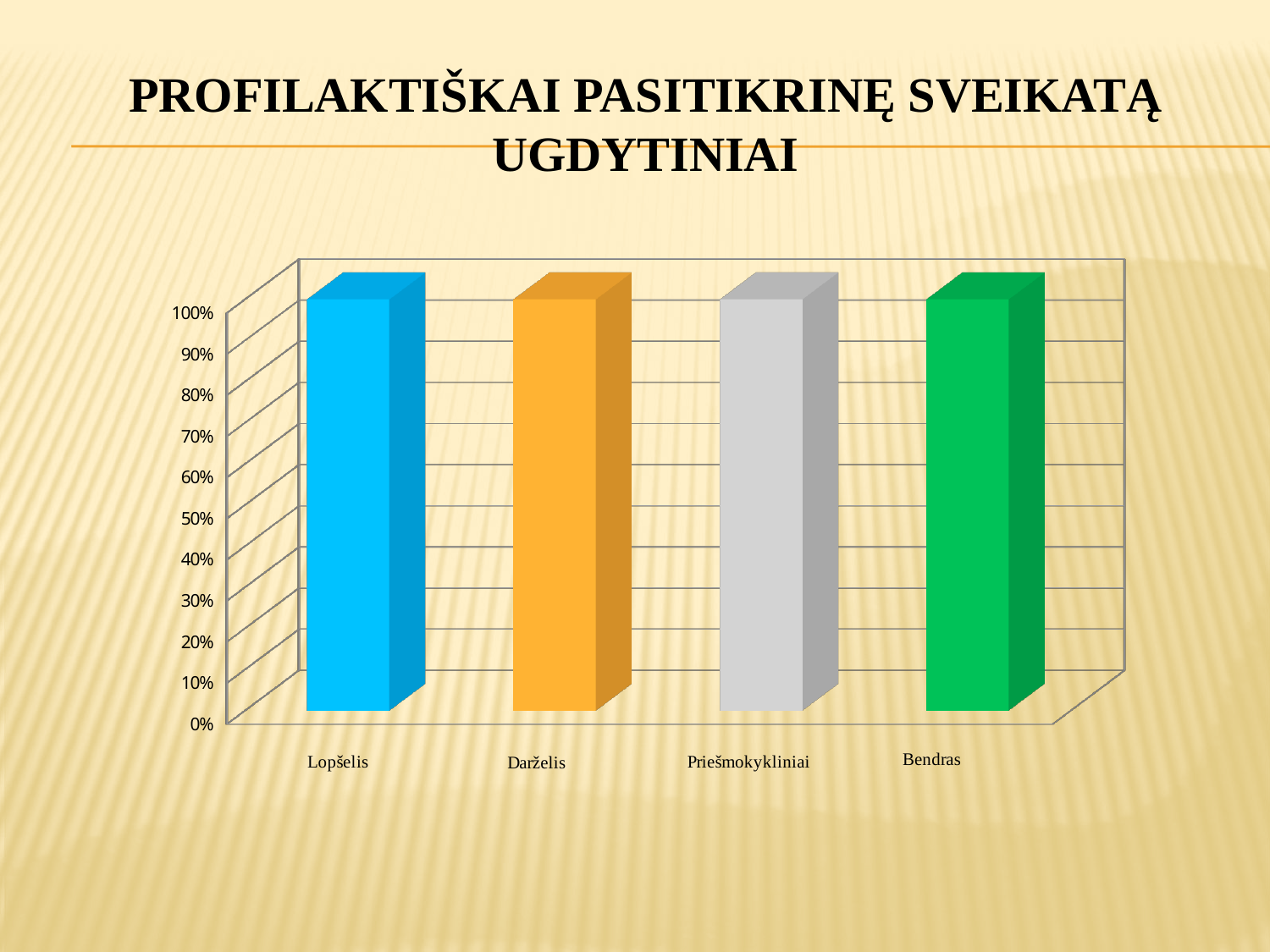
What is the value for Lopšelis? 100% What is the title of the slide containing the chart? PROFILAKTIŠKAI PASITIKRINĘ SVEIKATĄ UGDYTINIAI What is the value for Darželis? 100% What is the highest value shown on the y axis of the chart? 100% What is the value for Bendras? 100% Is the value for Bendras greater or less than 90%? greater What is the value for Priešmokykliniai? 100% How many categories are shown on the x axis of the chart? 4 What colour is the bar for Bendras? green What kind of chart is shown on the slide? bar chart Is the value for Priešmokykliniai greater or less than 80%? greater Is the value for Lopšelis greater or less than 50%? greater